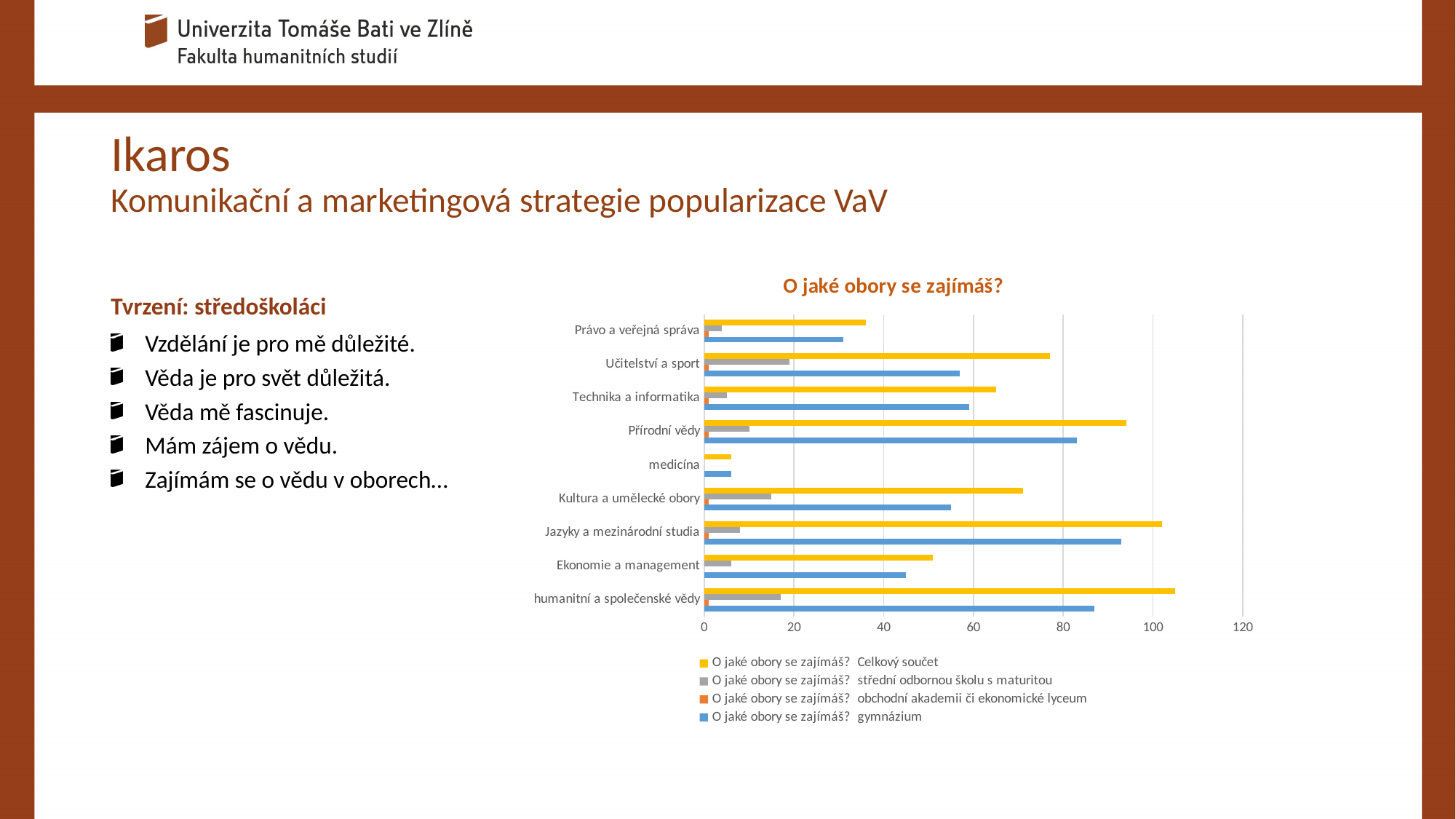
What kind of chart is shown on the slide? bar chart Which series is drawn in yellow on the chart? O jaké obory se zajímáš? Celkový součet Is the 'Celkový součet' value for medicína greater or less than 20? less Which category has the lowest value for the 'Celkový součet' series? medicína How many categories (fields of study) are shown on the chart's vertical axis? 9 Is the 'Celkový součet' value for Ekonomie a management greater or less than 40? greater What is the title of the chart? O jaké obory se zajímáš? Is the 'Celkový součet' value for Přírodní vědy greater or less than 80? greater For the 'gymnázium' series, which is larger: Přírodní vědy or Kultura a umělecké obory? Přírodní vědy How many series does the chart's legend list? 4 For the 'Celkový součet' series, which is larger: Učitelství a sport or Technika a informatika? Učitelství a sport